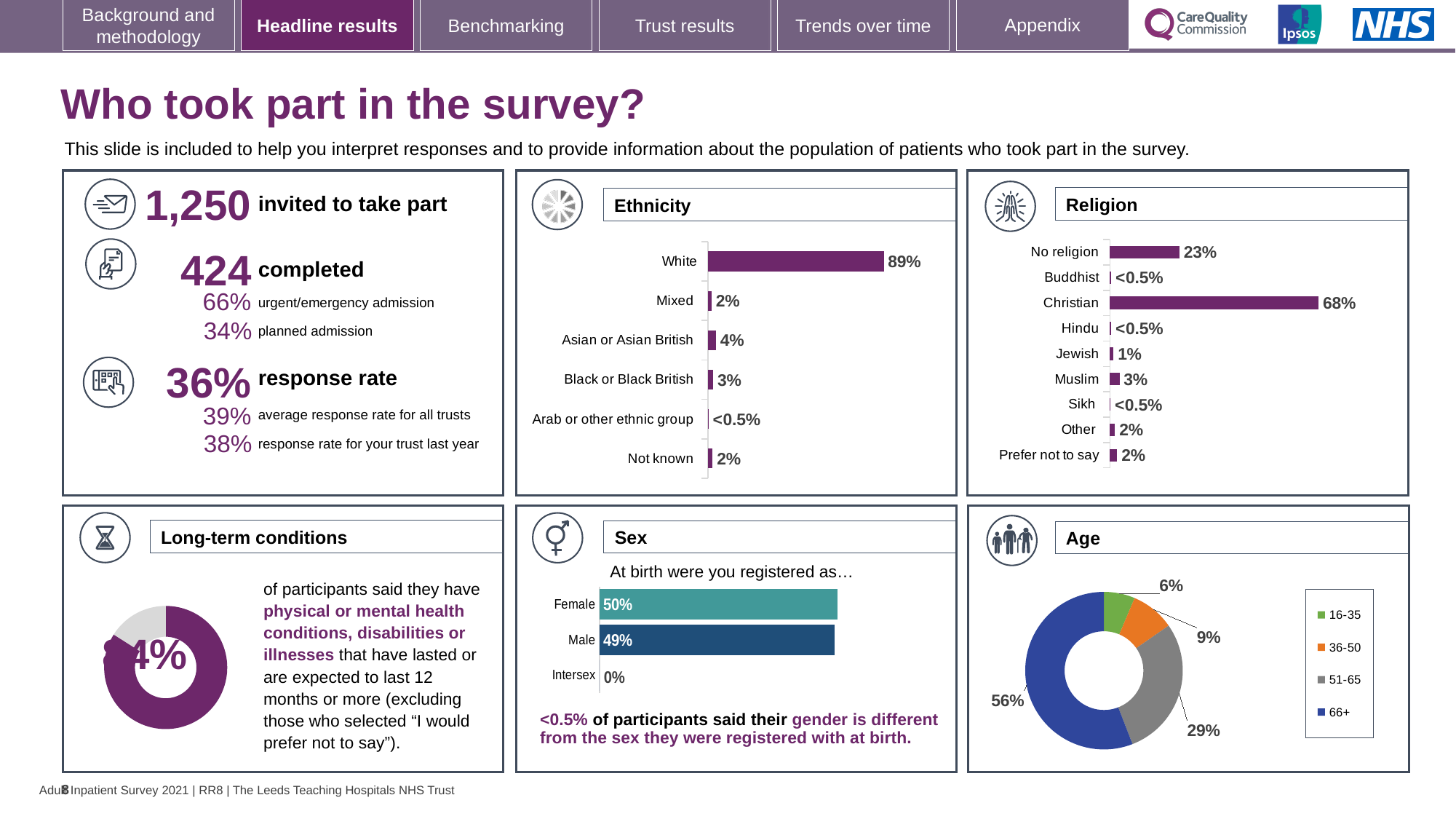
In the Ethnicity chart, which ethnic group has the lowest percentage? Arab or other ethnic group In the Religion chart, which religion category has the highest percentage? Christian In the Ethnicity chart, how many ethnic group categories are shown? 6 In the Sex chart, what percentage of participants were registered as Female at birth? 50% In the Religion chart, what is the difference between the percentages for Christian and No religion? 45% In the Ethnicity chart, what is the difference between the percentages for Asian or Asian British and Black or Black British? 1% In the Religion chart, what percentage of participants were Christian? 68% In the Age chart, what percentage of participants were aged 66+? 56% In the Ethnicity chart, what percentage of participants were White? 89% In the Sex chart, which is larger, the percentage for Female or for Male? Female In the Age chart, how many age groups does the legend list? 4 In the Religion chart, how many categories are listed? 9